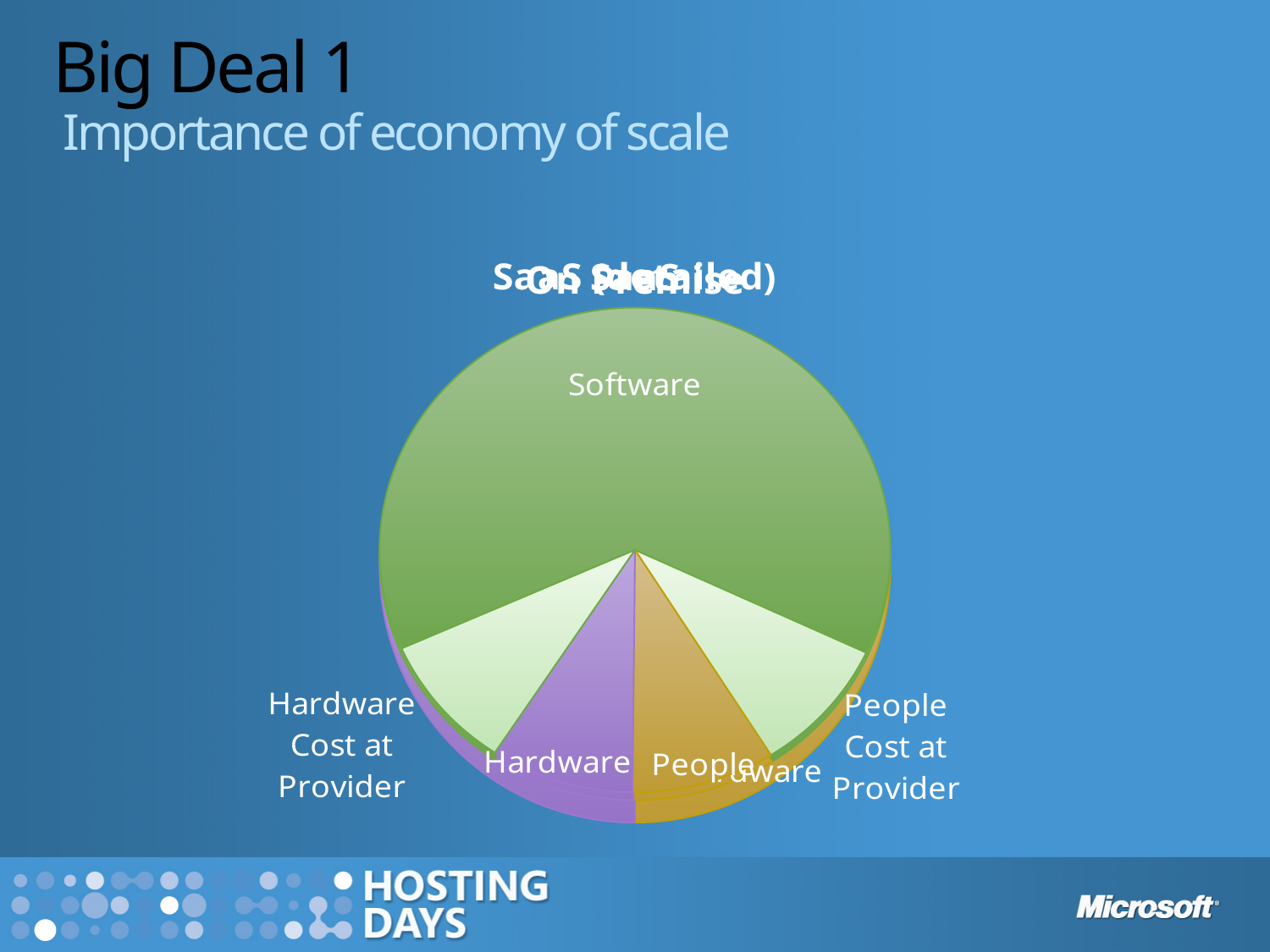
What colour is the Software slice in the pie chart? green Which slice of the pie chart is the largest? Software Which is larger in the pie chart, the Software slice or the Hardware slice? Software Does the Software slice take up more or less than half of the pie? more What kind of chart is shown on the slide? pie chart What colour is the Hardware slice in the pie chart? purple Which is larger in the pie chart, the Software slice or the People slice? Software